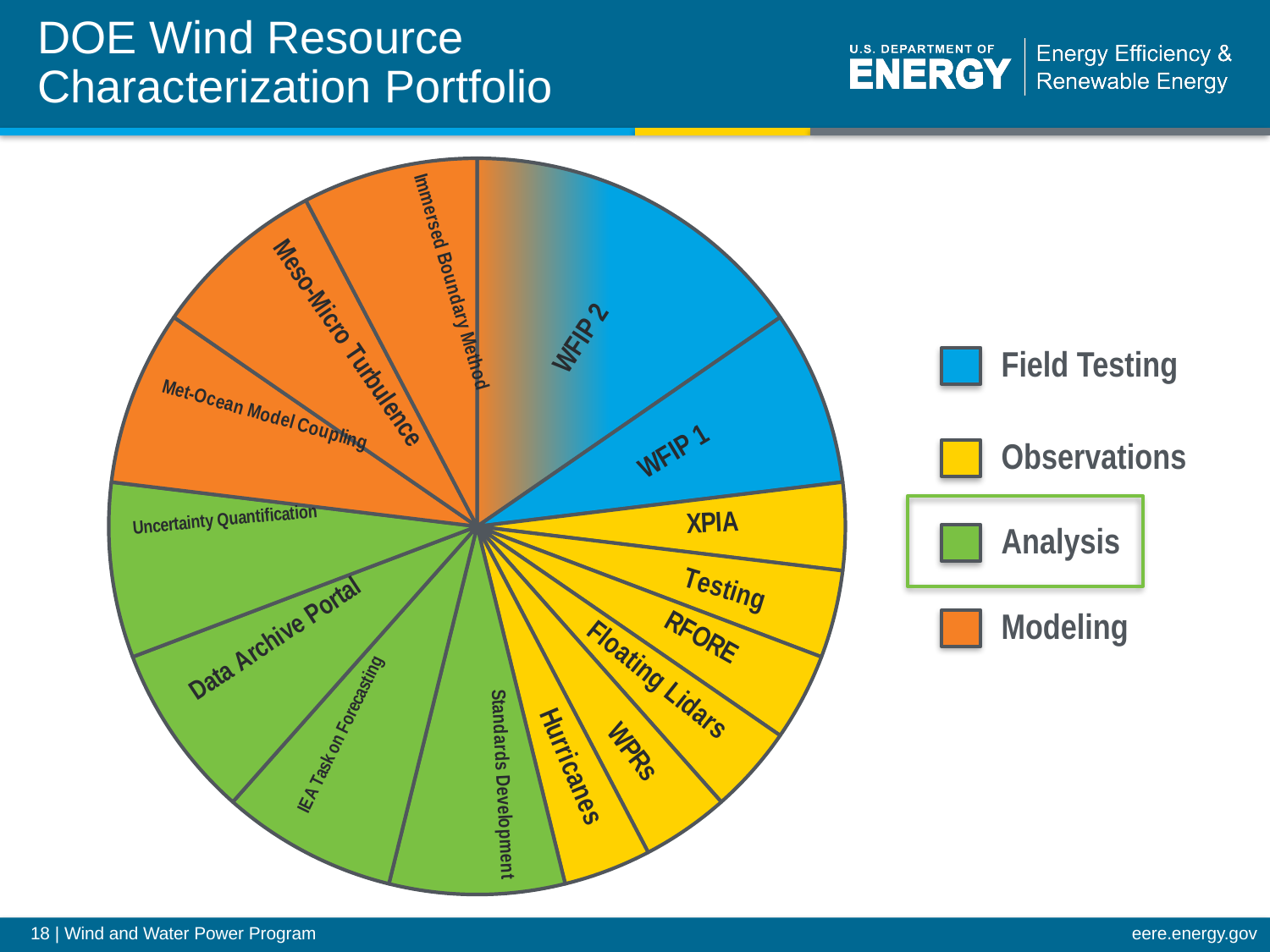
What kind of chart is shown on the slide? pie chart Which slice is larger, Data Archive Portal or Hurricanes? Data Archive Portal Which legend category do the blue slices WFIP 1 and WFIP 2 belong to? Field Testing Which slice is larger, Meso-Micro Turbulence or XPIA? Meso-Micro Turbulence Which slice is larger, WFIP 2 or WFIP 1? WFIP 2 How many slices belong to the Observations (yellow) category? 6 How many slices belong to the Modeling (orange) category? 3 How many categories does the legend list? 4 How many slices does the pie chart have? 15 Which slice of the pie chart is the largest? WFIP 2 Which legend entry is highlighted with a green outline box? Analysis